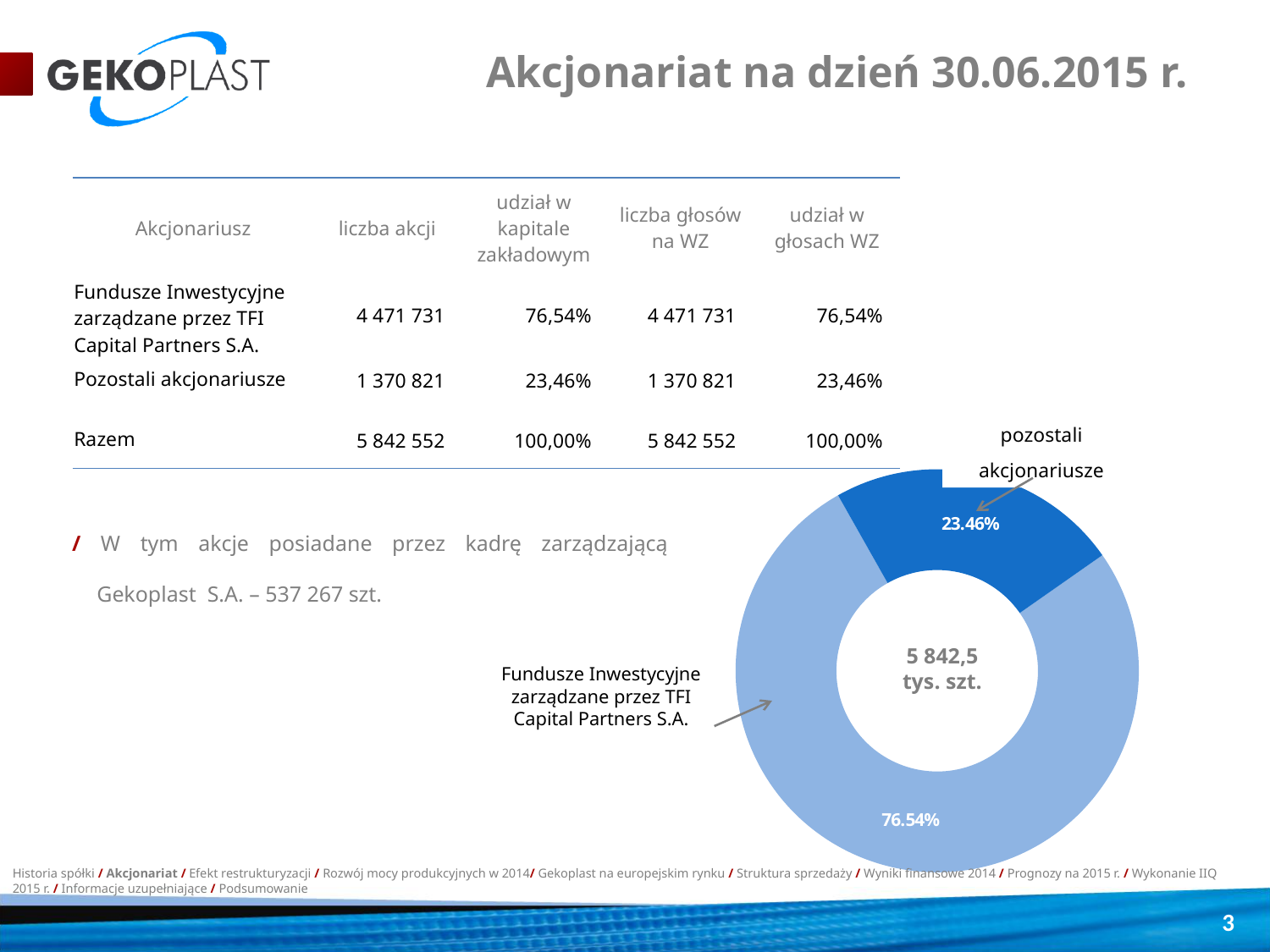
How many slices does the donut chart have? 2 Is the share for pozostali akcjonariusze in the donut chart greater or less than 50%? less What is the difference in percentage points between the two slices of the donut chart? 53.08 percentage points What share of the donut chart is labelled for pozostali akcjonariusze? 23.46% What total is printed in the centre of the donut chart? 5 842,5 tys. szt. What share of the donut chart is labelled for Fundusze Inwestycyjne zarządzane przez TFI Capital Partners S.A.? 76.54% Which slice of the donut chart is the largest? Fundusze Inwestycyjne zarządzane przez TFI Capital Partners S.A. Which is larger in the donut chart: the share for pozostali akcjonariusze or the share for Fundusze Inwestycyjne zarządzane przez TFI Capital Partners S.A.? Fundusze Inwestycyjne zarządzane przez TFI Capital Partners S.A. What kind of chart is shown on the slide? Donut (pie) chart Which slice of the donut chart is drawn in the darker blue colour? pozostali akcjonariusze Which slice of the donut chart is the smallest? pozostali akcjonariusze